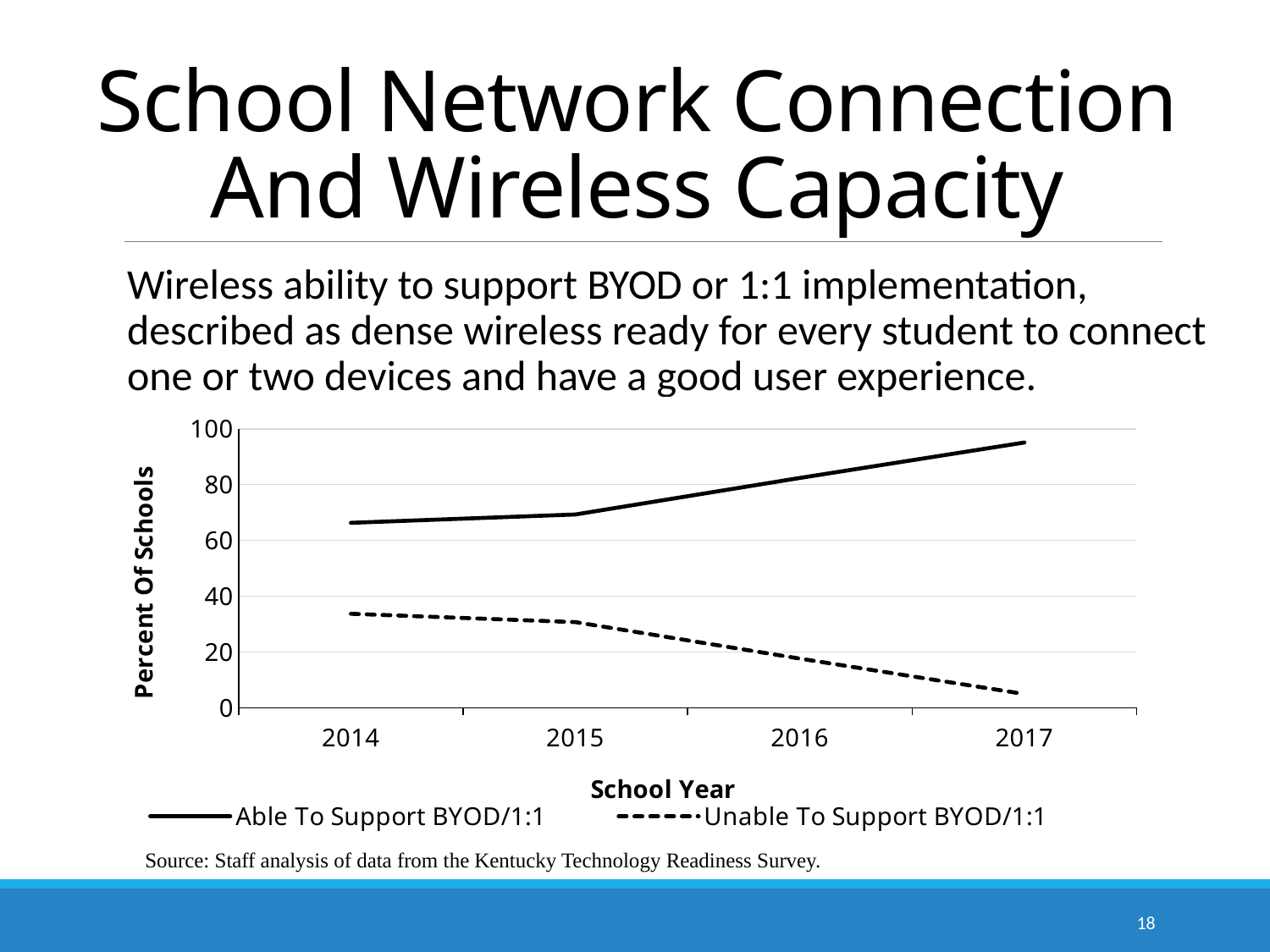
Does the Able To Support BYOD/1:1 line rise or fall from 2014 to 2017? rise Does the Unable To Support BYOD/1:1 line rise or fall from 2014 to 2017? fall In which school year is the Able To Support BYOD/1:1 value highest? 2017 In 2016, which series has the larger value, Able To Support BYOD/1:1 or Unable To Support BYOD/1:1? Able To Support BYOD/1:1 What kind of chart is shown on the slide? line chart How many series does the chart legend list? 2 Is the value for Unable To Support BYOD/1:1 in 2017 greater or less than 20? less What is the label of the y axis? Percent Of Schools How many school years are plotted on the x axis? 4 Is the value for Able To Support BYOD/1:1 in 2014 greater or less than 60? greater Is the value for Able To Support BYOD/1:1 in 2017 greater or less than 80? greater In which school year is the Unable To Support BYOD/1:1 value lowest? 2017